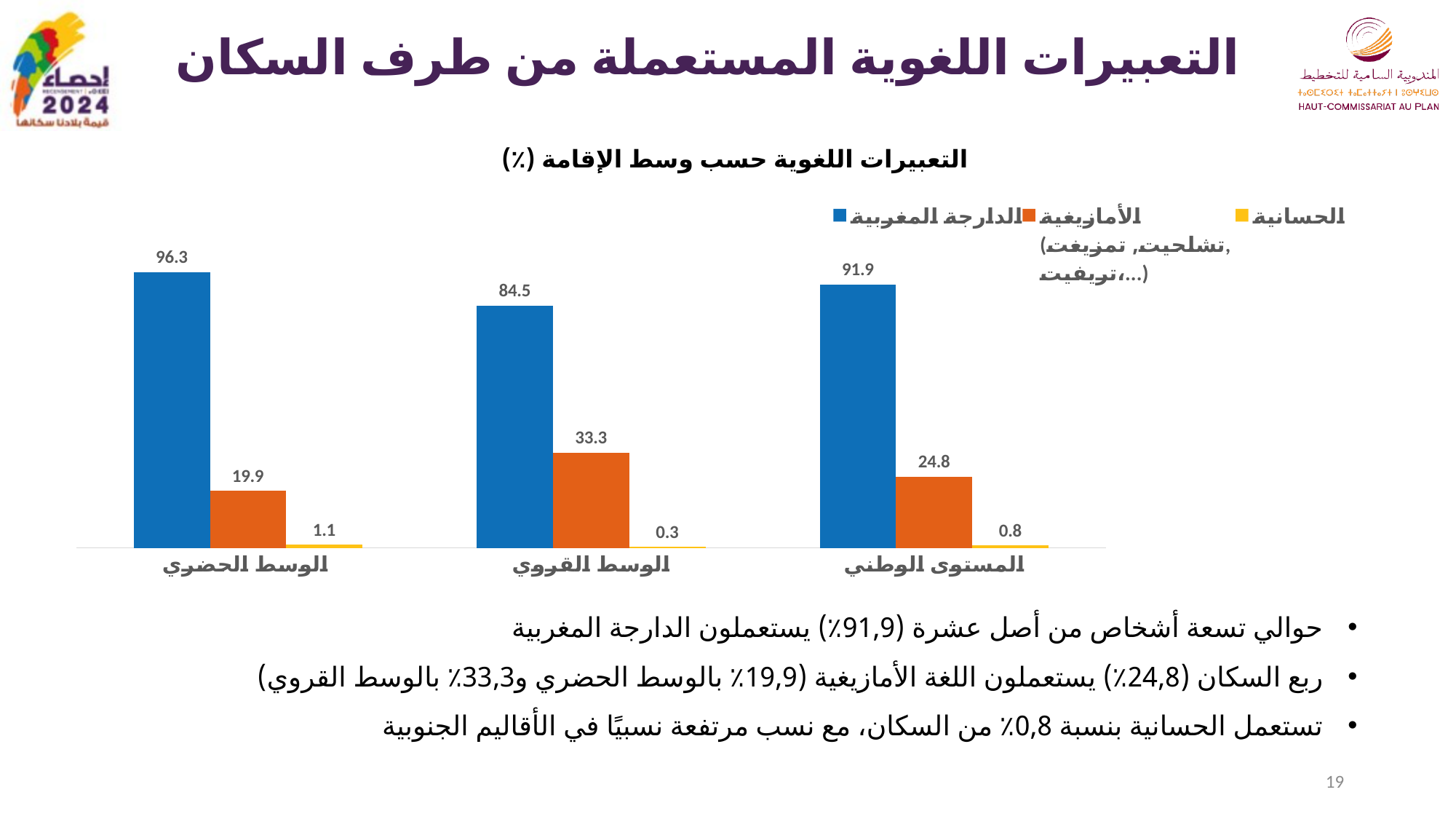
Which is larger: the الأمازيغية value for الوسط الحضري or for المستوى الوطني? المستوى الوطني What kind of chart is shown on the slide? bar chart What is the difference between the الدارجة المغربية values for الوسط الحضري and الوسط القروي? 11.8 What value is shown for الدارجة المغربية in الوسط الحضري? 96.3 What value is shown for الحسانية at المستوى الوطني? 0.8 Which colour represents الحسانية in the chart? yellow How many residence-area categories are shown on the x axis? 3 What value is shown for الدارجة المغربية at المستوى الوطني? 91.9 What value is shown for الأمازيغية in الوسط القروي? 33.3 In which residence area is the value for الأمازيغية highest? الوسط القروي How many series does the legend list? 3 In which residence area is the value for الحسانية lowest? الوسط القروي